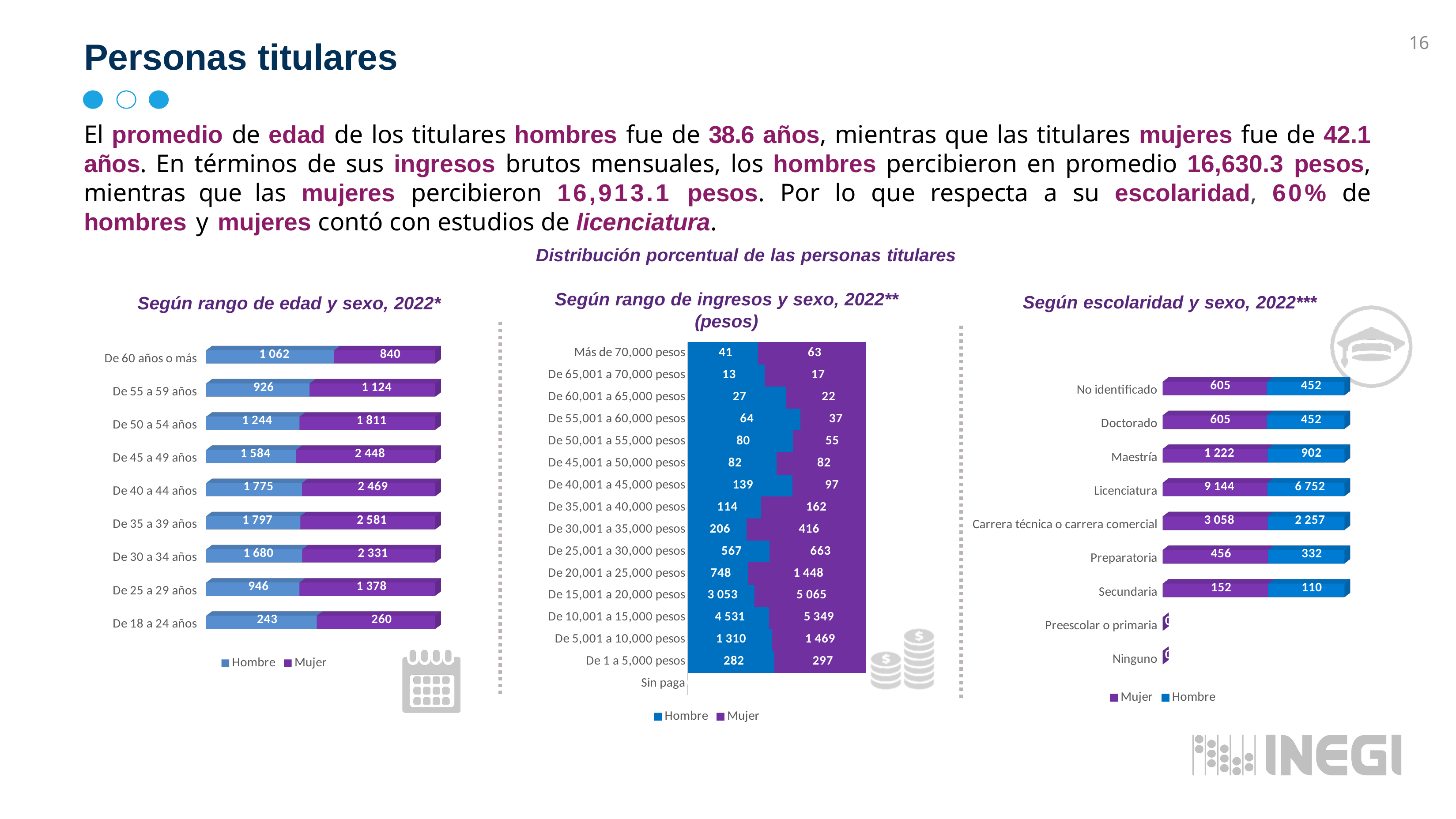
In the chart 'Según rango de edad y sexo, 2022*', how many age ranges are shown? 9 What kind of chart is 'Según escolaridad y sexo, 2022***'? Stacked bar chart In the chart 'Según rango de ingresos y sexo, 2022** (pesos)', how many series does the legend list? 2 In the chart 'Según rango de edad y sexo, 2022*', which age range has the highest Mujer value? De 35 a 39 años In the chart 'Según rango de edad y sexo, 2022*', what is the value for Hombre in the 'De 35 a 39 años' category? 1 797 In the chart 'Según rango de ingresos y sexo, 2022** (pesos)', what is the difference between the Mujer and Hombre values for 'De 20,001 a 25,000 pesos'? 700 In the chart 'Según rango de ingresos y sexo, 2022** (pesos)', which income range has the highest Hombre value? De 10,001 a 15,000 pesos In the chart 'Según rango de edad y sexo, 2022*', what is the total of the stacked bar for 'De 60 años o más'? 1 902 In the chart 'Según escolaridad y sexo, 2022***', which is larger for 'Carrera técnica o carrera comercial', the Mujer value or the Hombre value? Mujer In the chart 'Según rango de ingresos y sexo, 2022** (pesos)', what is the value for Mujer in the 'De 15,001 a 20,000 pesos' category? 5 065 In the chart 'Según escolaridad y sexo, 2022***', what is the value for Hombre in the 'Licenciatura' category? 6 752 In the chart 'Según rango de edad y sexo, 2022*', what is the value for Mujer in the 'De 18 a 24 años' category? 260